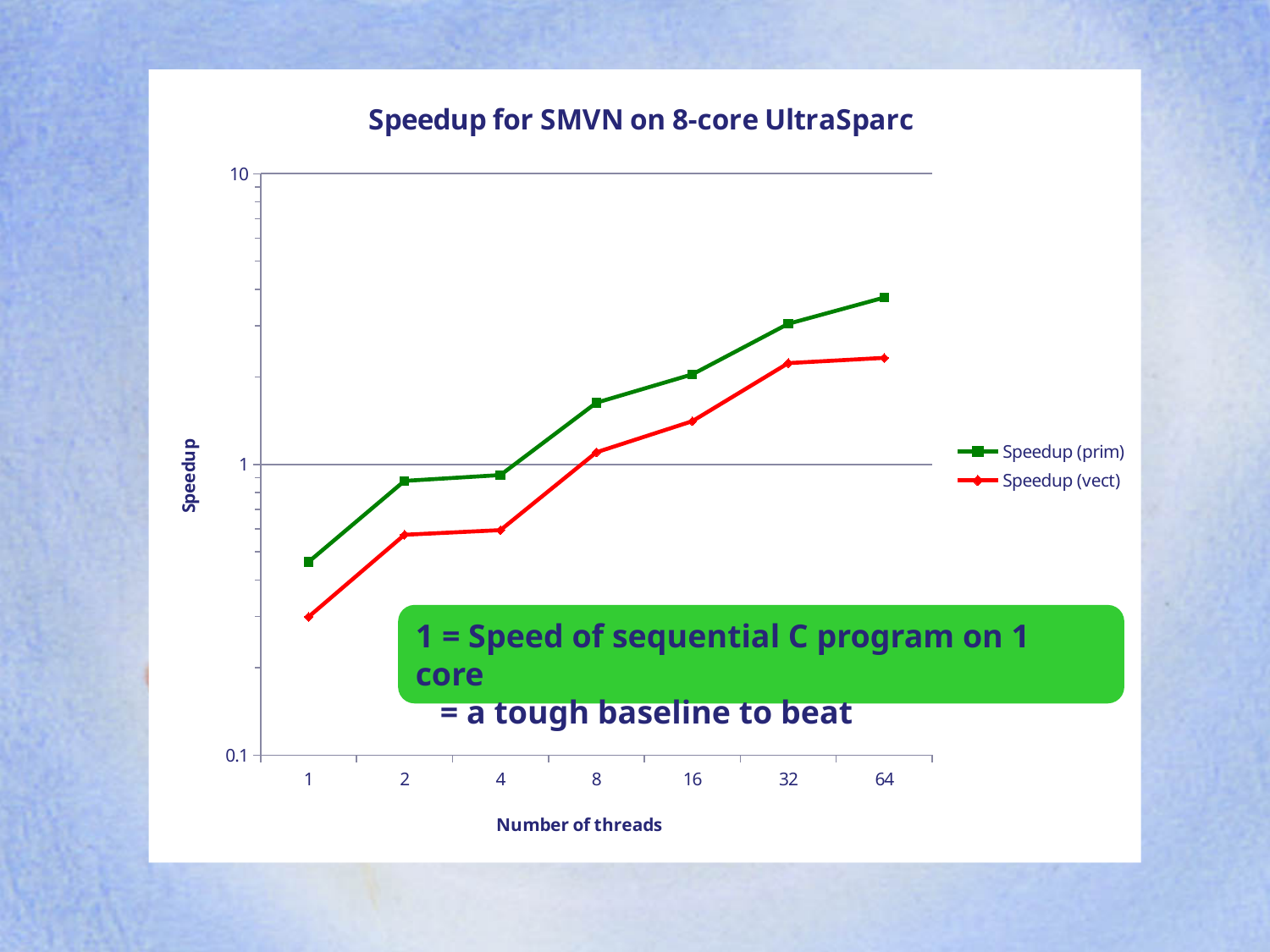
Which series is drawn in green? Speedup (prim) Is the value for Speedup (vect) at 64 threads greater or less than 1? greater What kind of chart is shown on the slide? line chart How many thread counts are plotted along the x axis? 7 What is the title of the chart? Speedup for SMVN on 8-core UltraSparc At which number of threads is Speedup (prim) highest? 64 How many series does the legend list? 2 Is the value for Speedup (prim) at 8 threads greater or less than 1? greater Is the value for Speedup (vect) at 4 threads greater or less than 1? less At 64 threads, which series has the larger speedup, Speedup (prim) or Speedup (vect)? Speedup (prim)